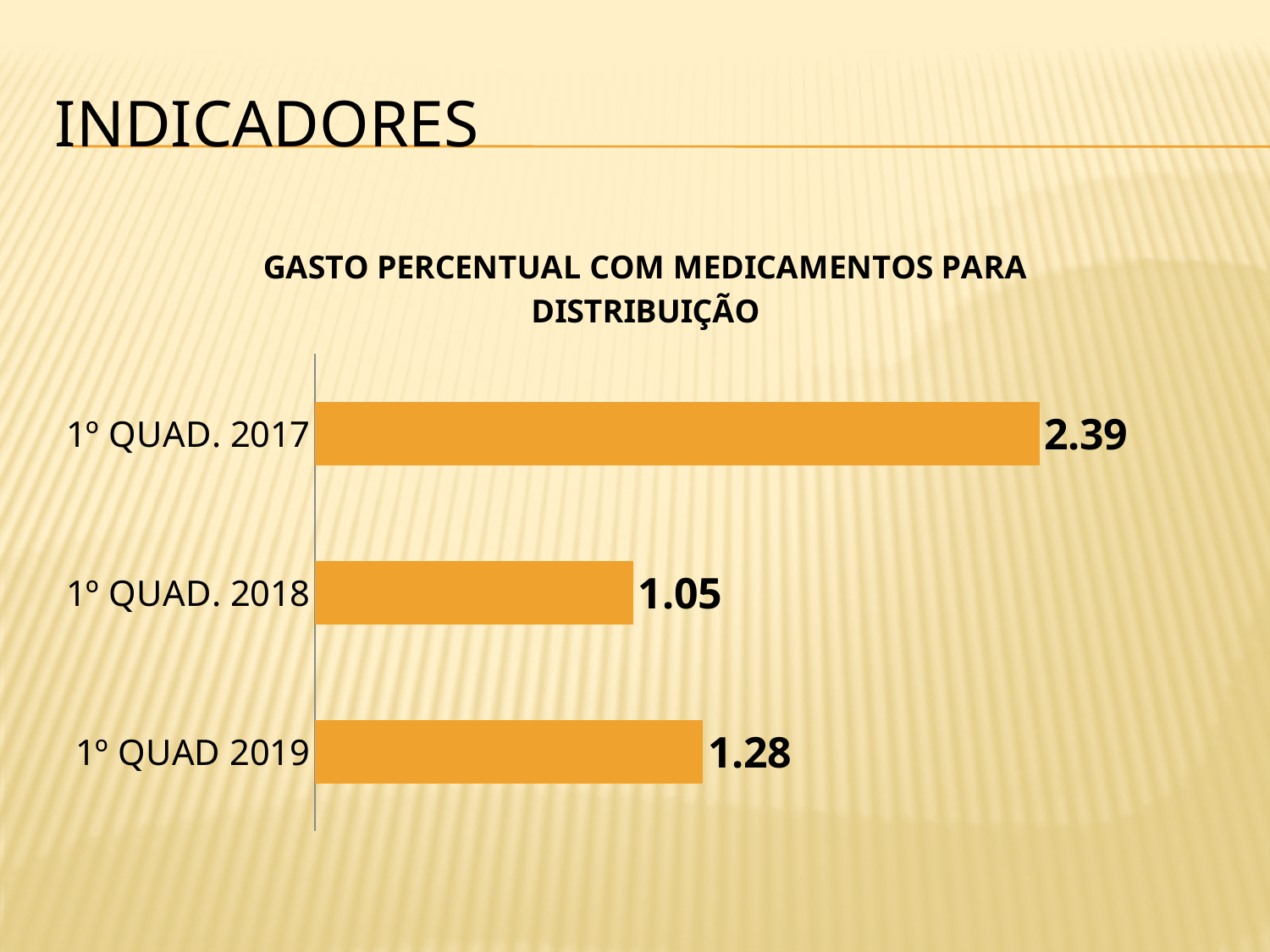
How many categories are shown in the chart? 3 What is the value for 1º QUAD. 2017? 2.39 Which is larger, the value for 1º QUAD. 2018 or 1º QUAD 2019? 1º QUAD 2019 What is the value for 1º QUAD. 2018? 1.05 What is the difference between the values for 1º QUAD 2019 and 1º QUAD. 2018? 0.23 What is the difference between the values for 1º QUAD. 2017 and 1º QUAD. 2018? 1.34 Which category has the highest value? 1º QUAD. 2017 Which category has the lowest value? 1º QUAD. 2018 What is the title of the chart? GASTO PERCENTUAL COM MEDICAMENTOS PARA DISTRIBUIÇÃO What kind of chart is shown on the slide? Bar chart What is the value for 1º QUAD 2019? 1.28 What colour are the bars in the chart? Orange